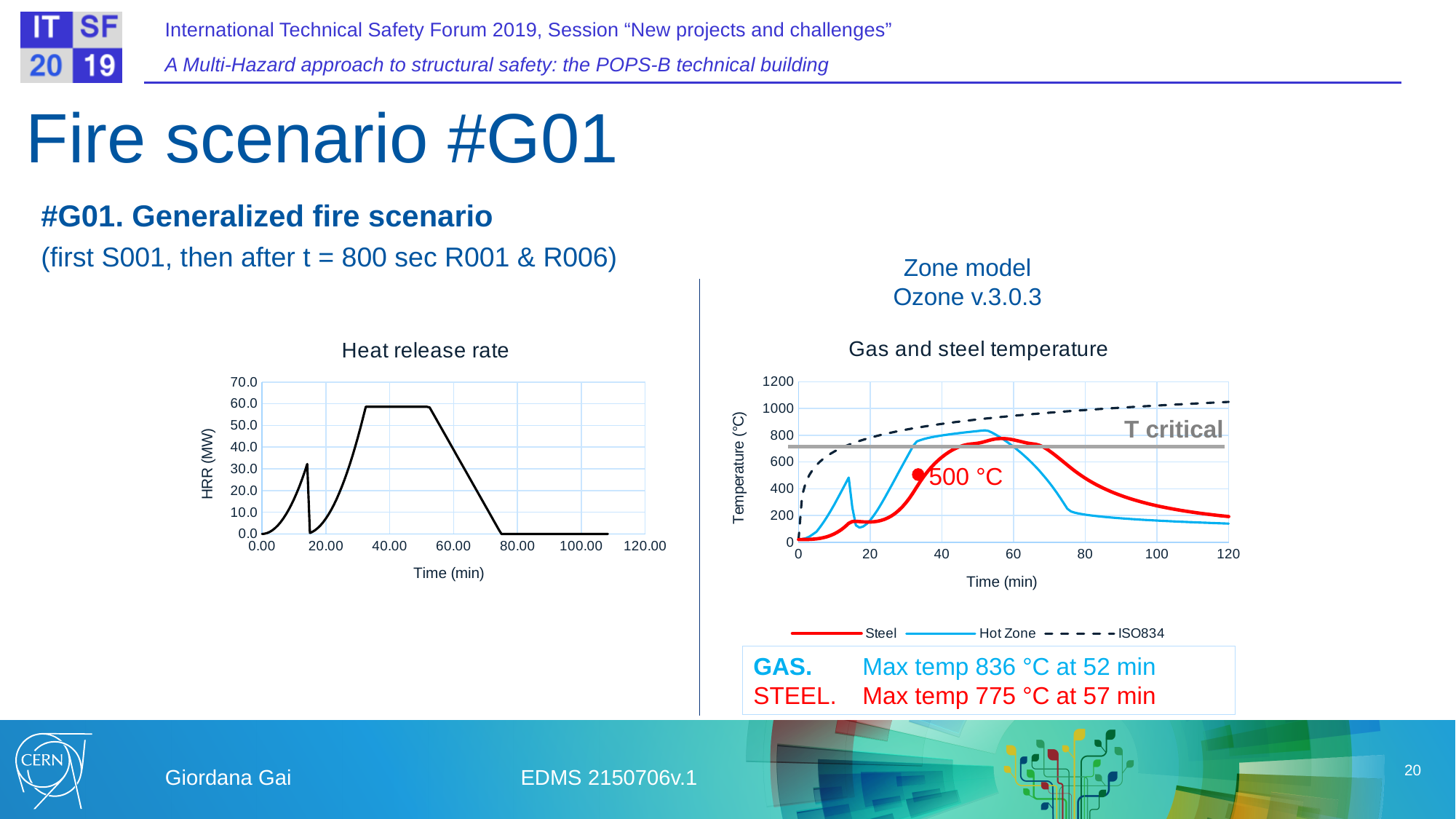
In the "Gas and steel temperature" chart, does the ISO834 curve rise or fall along the time axis? rises What is the y-axis label of the "Heat release rate" chart? HRR (MW) What kind of chart is the "Heat release rate" chart? line chart In the "Heat release rate" chart, is the HRR value at 100.00 min greater or less than 10.0? less How many series does the legend of the "Gas and steel temperature" chart list? 3 In the "Gas and steel temperature" chart, at what time does the steel reach its maximum temperature? 57 min In the "Gas and steel temperature" chart, which reaches a higher maximum temperature, Steel or Hot Zone? Hot Zone In the "Gas and steel temperature" chart, which series has the highest temperature at 120 min? ISO834 In the "Heat release rate" chart, is the plateau value of HRR between 40 and 50 min greater or less than 50.0? greater What are the legend entries of the "Gas and steel temperature" chart? Steel, Hot Zone, ISO834 In the "Gas and steel temperature" chart, what is the maximum gas temperature stated on the slide? 836 °C In the "Gas and steel temperature" chart, what is the difference between the maximum gas temperature and the maximum steel temperature? 61 °C